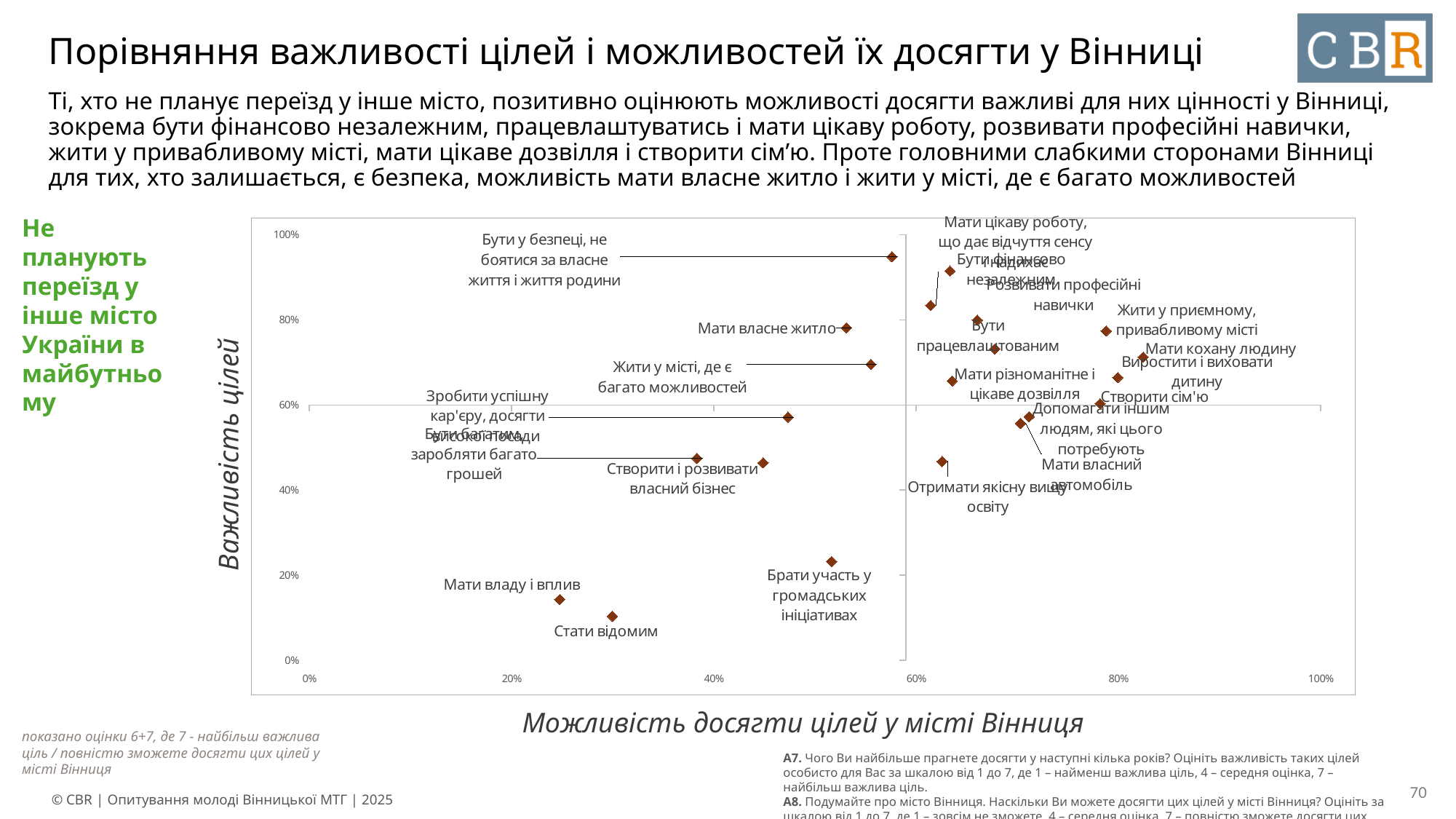
Is the possibility (horizontal axis) value for "Мати власне житло" greater or less than 60%? less Is the possibility (horizontal axis) value for "Мати кохану людину" greater or less than 80%? greater Is the possibility (horizontal axis) value for "Мати владу і вплив" greater or less than 40%? less Which goal has the lowest possibility (horizontal axis) value on the chart? Мати владу і вплив What is the title of the vertical axis of the chart? Важливість цілей Which goal has the highest possibility (horizontal axis) value on the chart? Мати кохану людину Which has the higher possibility (horizontal axis) value: "Мати власне житло" or "Мати кохану людину"? Мати кохану людину What is the title of the horizontal axis of the chart? Можливість досягти цілей у місті Вінниця What kind of chart is shown on the slide? Scatter chart